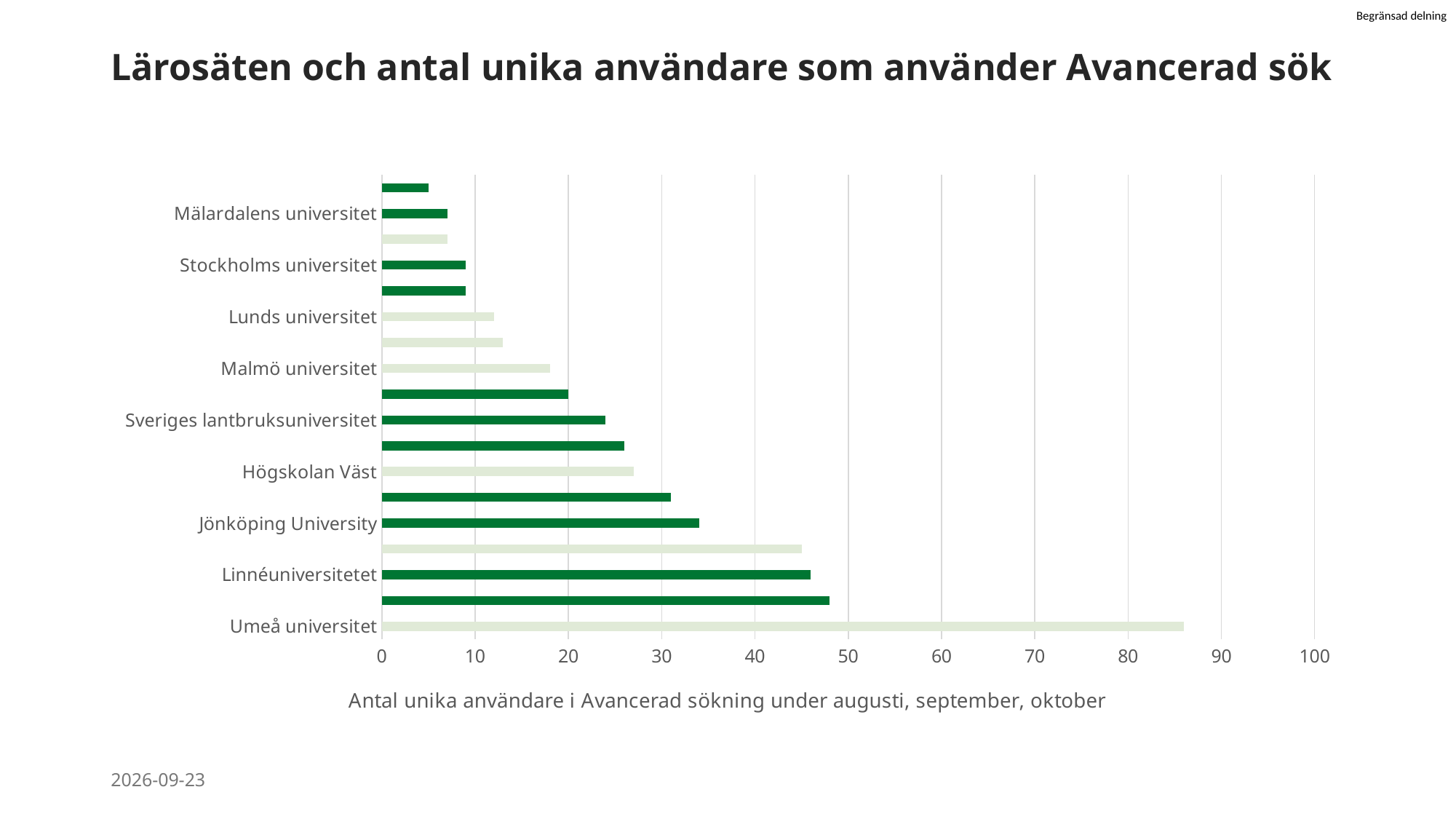
Is the value for Jönköping University greater or less than 30? greater Is the value for Linnéuniversitetet greater or less than 40? greater Which has more unique users, Jönköping University or Högskolan Väst? Jönköping University Is the value for Umeå universitet greater or less than 80? greater Do the bars get longer or shorter going from the top of the chart to the bottom? longer What kind of chart is shown on the slide? bar chart Which has more unique users, Umeå universitet or Linnéuniversitetet? Umeå universitet Which labelled university has the highest number of unique users? Umeå universitet What is the title of the horizontal axis? Antal unika användare i Avancerad sökning under augusti, september, oktober